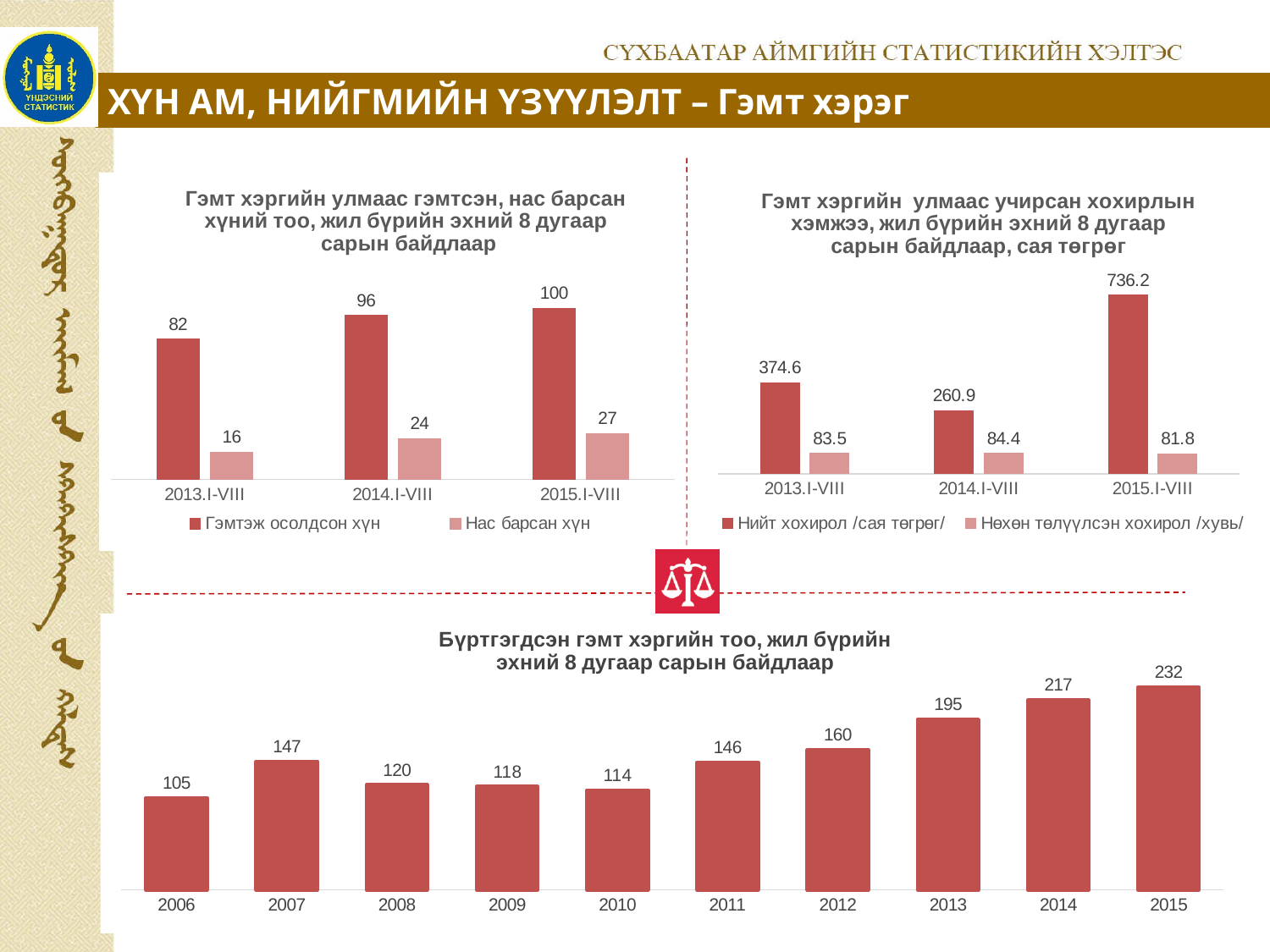
In the top-left chart (Гэмт хэргийн улмаас гэмтсэн, нас барсан хүний тоо), what is the value of Нас барсан хүн for 2013.I-VIII? 16 In the bottom chart (Бүртгэгдсэн гэмт хэргийн тоо), what is the value for 2013? 195 What kind of chart is the bottom chart (Бүртгэгдсэн гэмт хэргийн тоо)? bar chart In the top-left chart (Гэмт хэргийн улмаас гэмтсэн, нас барсан хүний тоо), how many series does the legend list? 2 In the bottom chart (Бүртгэгдсэн гэмт хэргийн тоо), how many years are shown on the x axis? 10 In the bottom chart (Бүртгэгдсэн гэмт хэргийн тоо), which year has the highest value? 2015 In the bottom chart (Бүртгэгдсэн гэмт хэргийн тоо), which year has the lowest value? 2006 In the bottom chart (Бүртгэгдсэн гэмт хэргийн тоо), what is the difference between the values for 2015 and 2014? 15 In the top-left chart (Гэмт хэргийн улмаас гэмтсэн, нас барсан хүний тоо), what is the value of Гэмтэж осолдсон хүн for 2014.I-VIII? 96 In the top-right chart (Гэмт хэргийн улмаас учирсан хохирлын хэмжээ), which is larger: Нийт хохирол for 2013.I-VIII or for 2014.I-VIII? 2013.I-VIII In the top-right chart (Гэмт хэргийн улмаас учирсан хохирлын хэмжээ), what is the value of Нийт хохирол for 2015.I-VIII? 736.2 In the bottom chart (Бүртгэгдсэн гэмт хэргийн тоо), do the values rise or fall from 2011 to 2015? rise